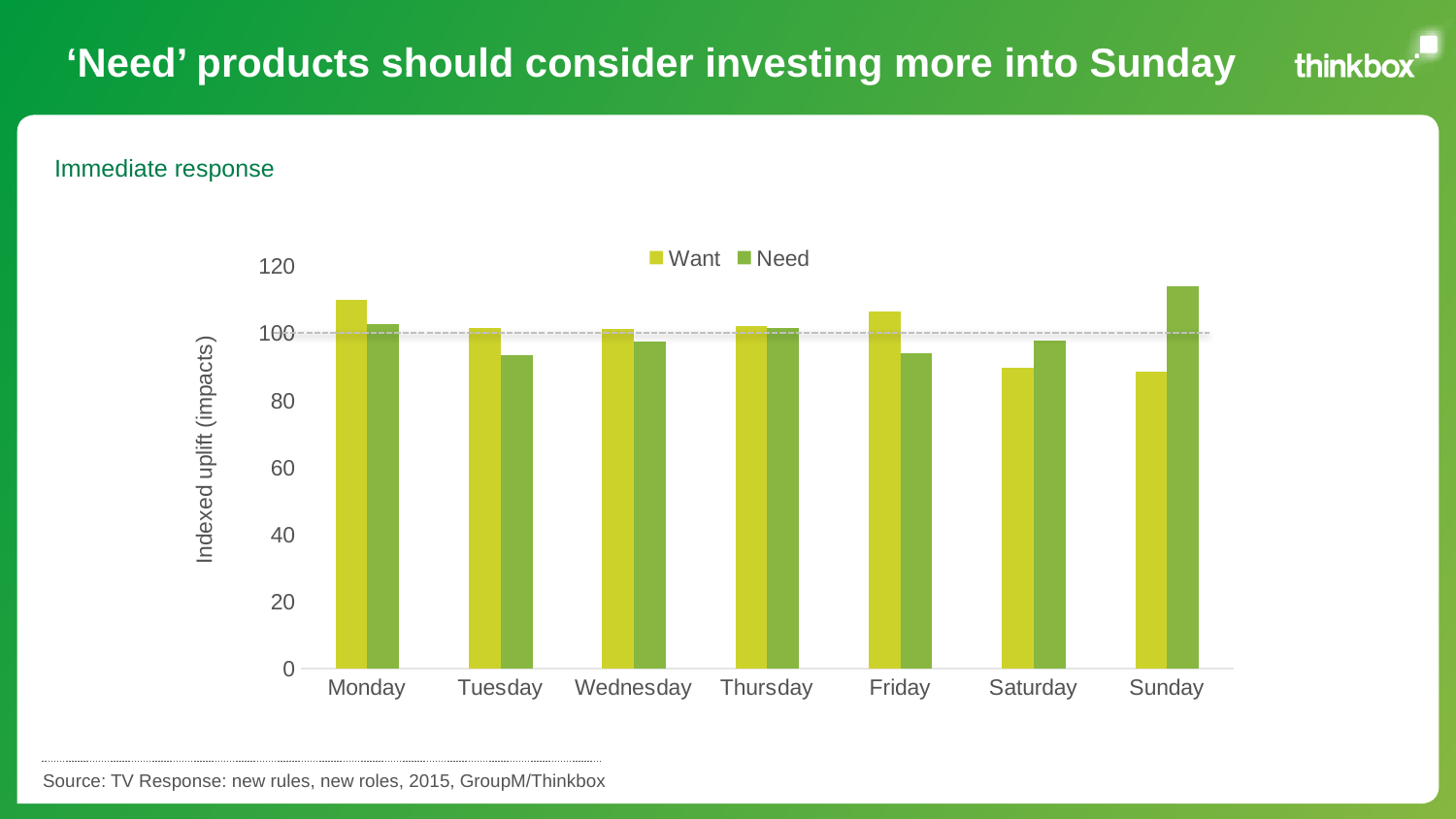
What are the two series named in the legend? Want and Need Is the Need value for Sunday greater or less than 100? greater How many days of the week are shown on the x axis? 7 What is the label on the y axis? Indexed uplift (impacts) On Sunday, which is larger: the Want value or the Need value? Need Which day has the highest value for the Want series? Monday What kind of chart is shown on the slide? bar chart Is the Want value for Saturday greater or less than 100? less Is the Need value for Tuesday greater or less than 100? less How many series does the legend list? 2 On Monday, which is larger: the Want value or the Need value? Want Which day has the highest value for the Need series? Sunday